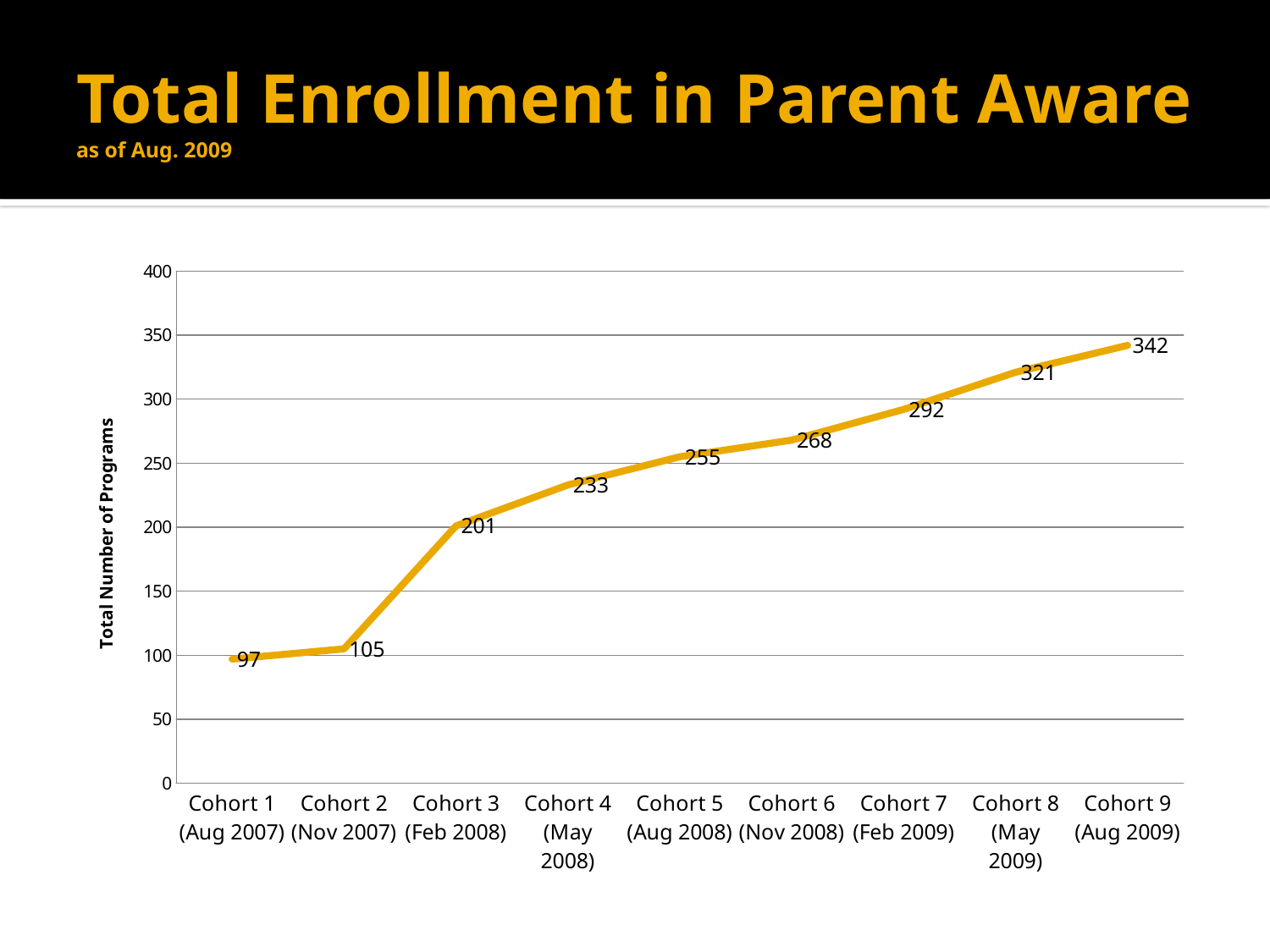
What kind of chart is shown on the slide? line chart What is the value for Cohort 9 (Aug 2009)? 342 Which cohort has the highest total number of programs? Cohort 9 (Aug 2009) How many cohorts are plotted on the chart? 9 Is the value for Cohort 6 (Nov 2008) greater or less than 250? greater Do the values rise or fall from Cohort 1 to Cohort 9? rise What is the total number of programs for Cohort 3 (Feb 2008)? 201 What is the difference between the values for Cohort 9 (Aug 2009) and Cohort 1 (Aug 2007)? 245 What is the value for Cohort 1 (Aug 2007)? 97 Which cohort has the lowest total number of programs? Cohort 1 (Aug 2007) What is the difference between the values for Cohort 3 (Feb 2008) and Cohort 2 (Nov 2007)? 96 Which is larger, the value for Cohort 5 (Aug 2008) or Cohort 7 (Feb 2009)? Cohort 7 (Feb 2009)